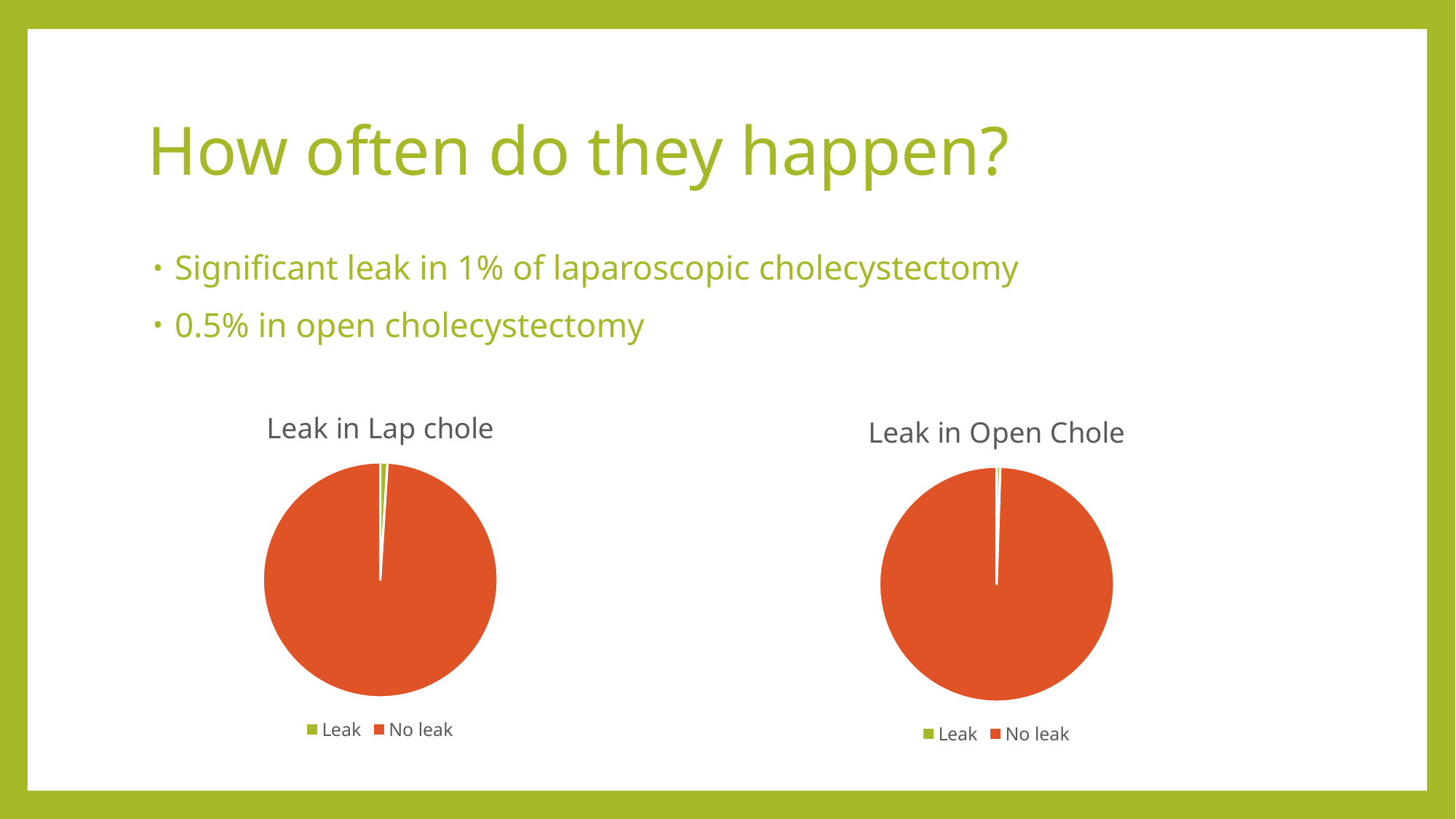
According to the slide, what share of the "Leak in Open Chole" pie does the Leak slice represent? 0.5% In the "Leak in Lap chole" pie chart, which slice is the largest? No leak In the "Leak in Open Chole" pie chart, which slice is the smallest? Leak How many entries does the legend of the "Leak in Lap chole" chart list? 2 How many slices does the "Leak in Open Chole" pie chart have? 2 According to the slide, what share of the "Leak in Lap chole" pie does the Leak slice represent? 1% What kind of chart is "Leak in Open Chole"? pie chart In the "Leak in Open Chole" pie chart, which slice is larger, Leak or No leak? No leak What kind of chart is "Leak in Lap chole"? pie chart What colour is the "No leak" slice in the "Leak in Lap chole" pie chart? orange How many slices does the "Leak in Lap chole" pie chart have? 2 What is the title of the pie chart on the right side of the slide? Leak in Open Chole